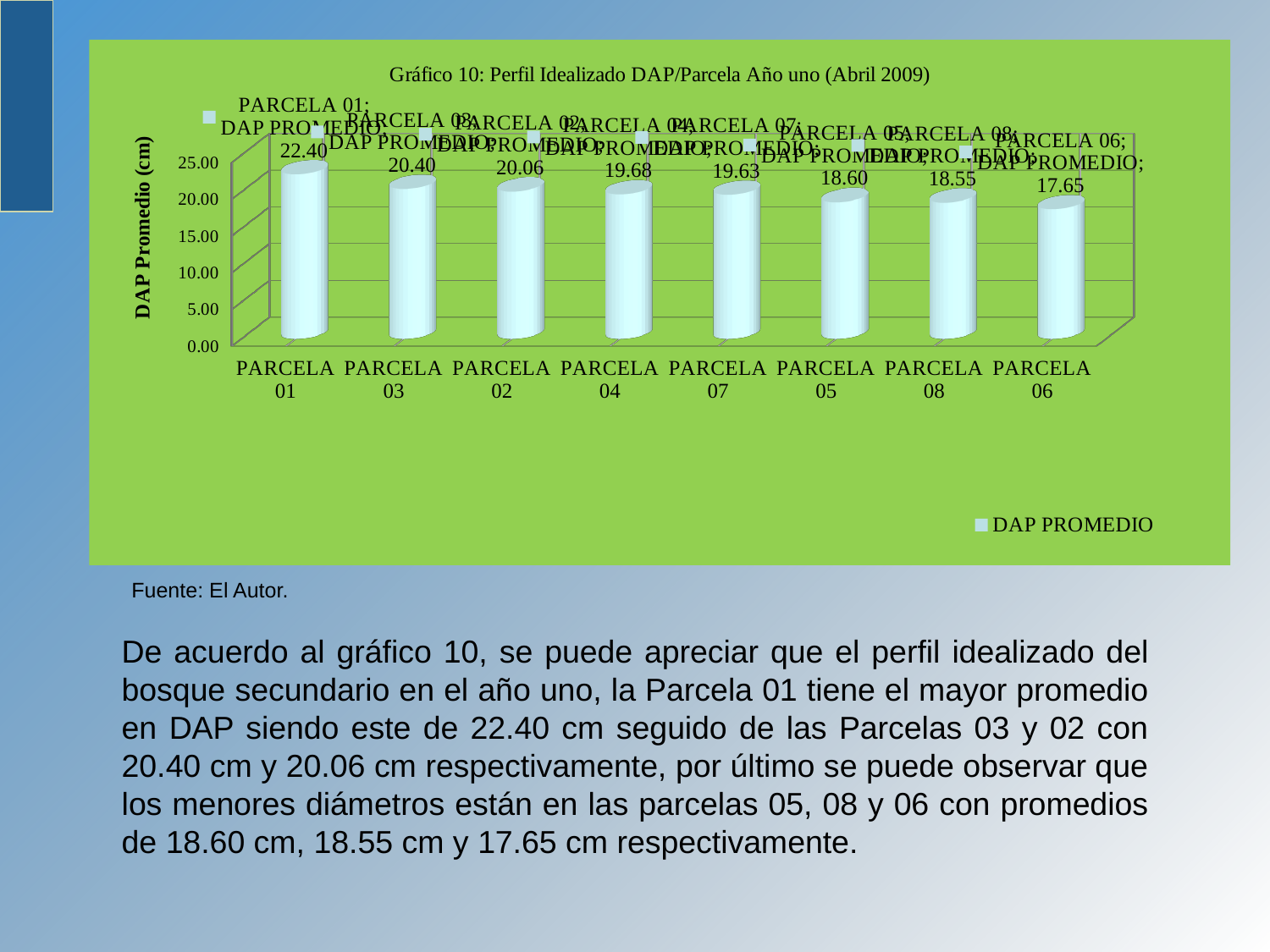
What is the DAP PROMEDIO value for PARCELA 01? 22.40 What kind of chart is shown on the slide? Bar chart Which parcela has the lowest DAP PROMEDIO? PARCELA 06 How many parcelas are shown on the x axis of the chart? 8 Which parcela has the highest DAP PROMEDIO? PARCELA 01 What is the DAP PROMEDIO value for PARCELA 06? 17.65 Do the DAP PROMEDIO values rise or fall from left to right along the x axis? Fall Which has a larger DAP PROMEDIO, PARCELA 03 or PARCELA 05? PARCELA 03 What is the difference between the DAP PROMEDIO of PARCELA 01 and PARCELA 03? 2.00 What is the difference between the DAP PROMEDIO of PARCELA 01 and PARCELA 06? 4.75 How many series does the legend list? 1 What is the DAP PROMEDIO value for PARCELA 04? 19.68